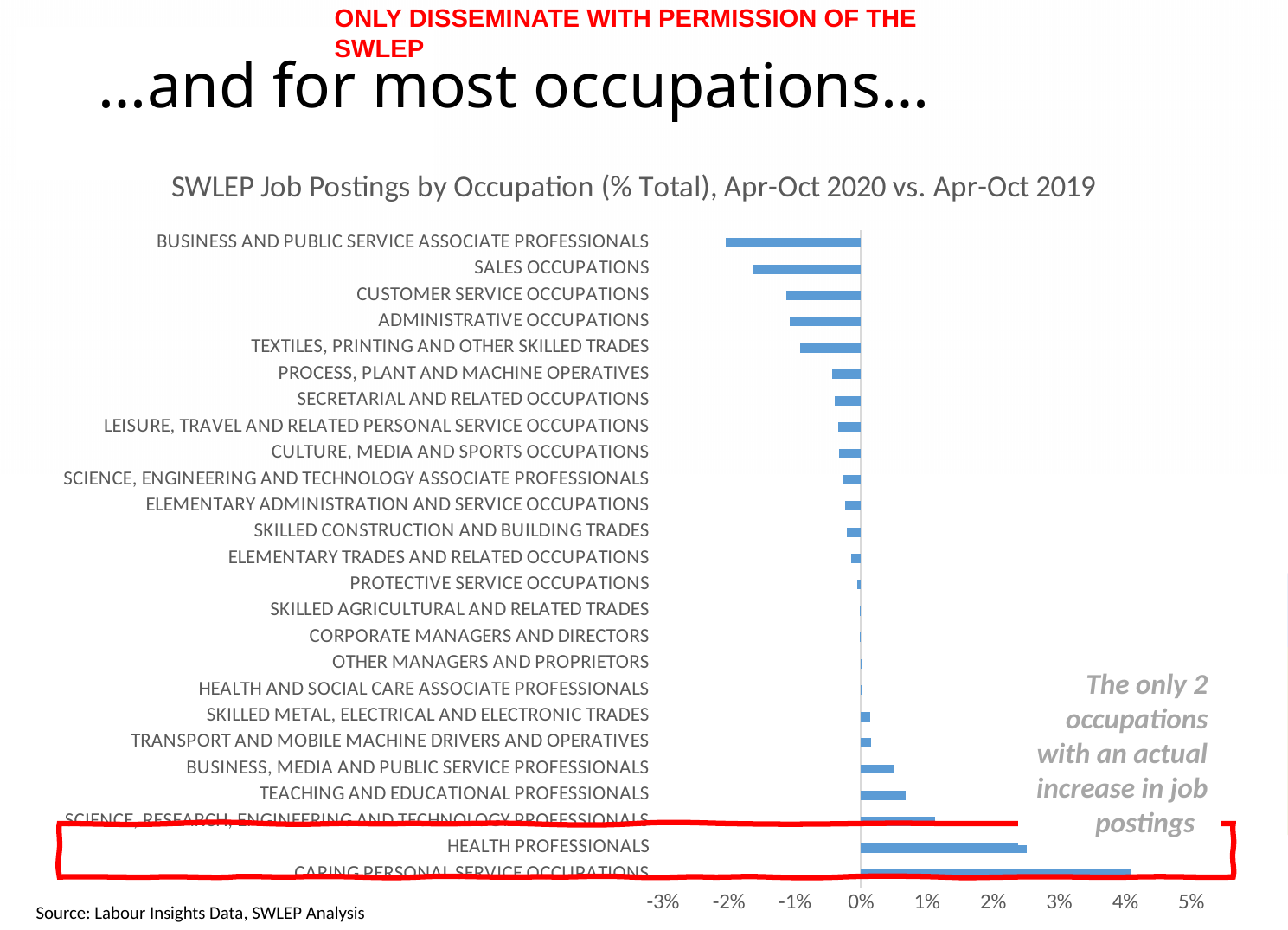
Is the value for Teaching and educational professionals greater or less than 1%? less Which occupation has the highest value in the chart? Caring personal service occupations How many occupation categories are shown in the chart? 25 Which has the larger value, Health professionals or Teaching and educational professionals? Health professionals What is the title of the chart? SWLEP Job Postings by Occupation (% Total), Apr-Oct 2020 vs. Apr-Oct 2019 Is the value for Health professionals greater or less than 2%? greater What is the source cited for the chart data? Labour Insights Data, SWLEP Analysis Which has the larger value, Sales occupations or Customer service occupations? Customer service occupations What kind of chart is shown on the slide? Bar chart Is the value for Sales occupations greater or less than -1%? less Which occupation has the lowest value in the chart? Business and public service associate professionals